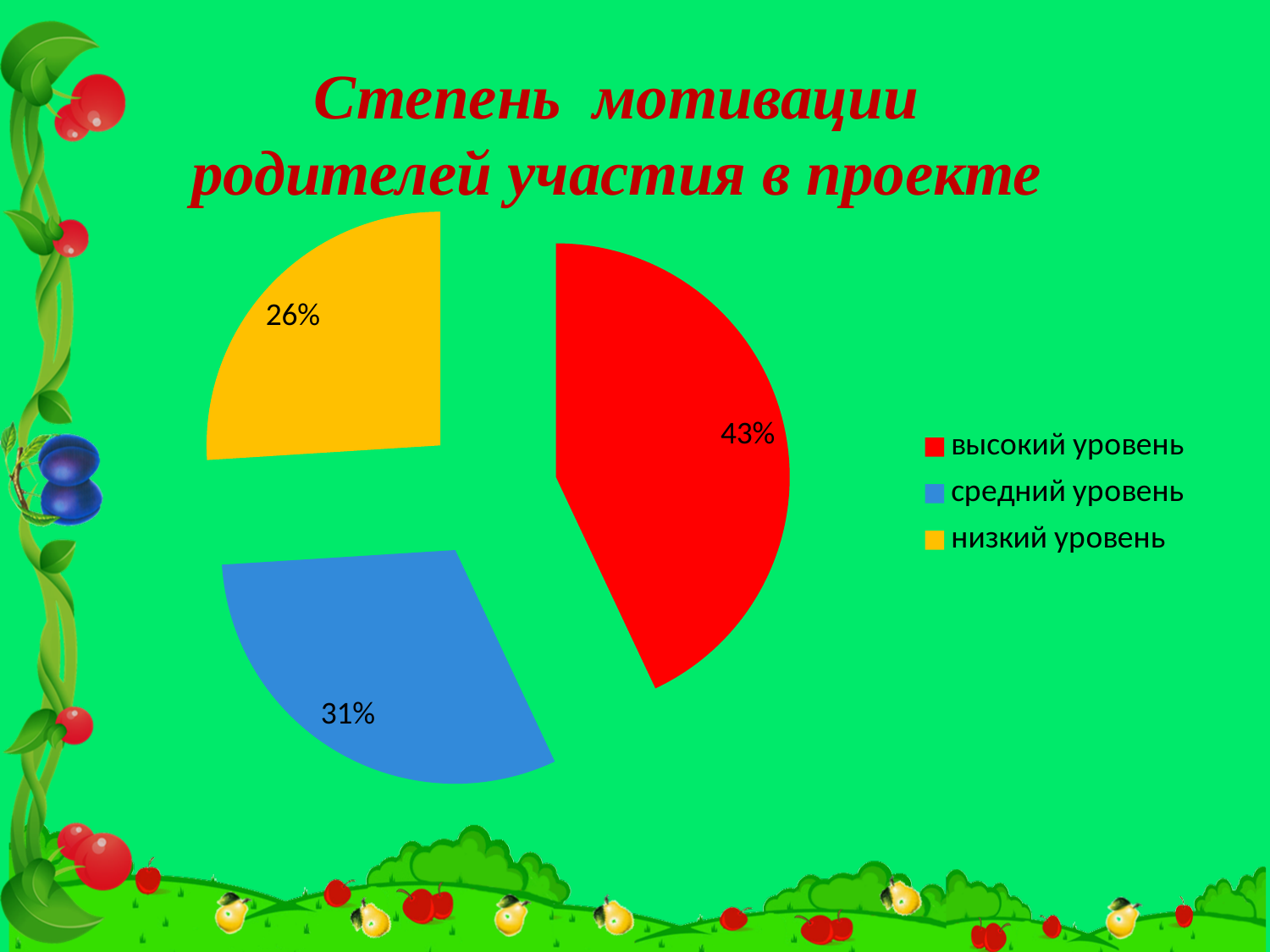
What percentage is shown for средний уровень? 31% Which category has the smallest share of the pie? низкий уровень What percentage is shown for низкий уровень? 26% What is the difference in percentage points between средний уровень and низкий уровень? 5 Which category has the largest share of the pie? высокий уровень How many slices does the pie chart have? 3 What kind of chart is shown on the slide? pie chart Which is larger, the share for средний уровень or the share for низкий уровень? средний уровень What is the title of the slide? Степень мотивации родителей участия в проекте What percentage is shown for высокий уровень? 43% What colour is the slice for средний уровень? blue What is the difference in percentage points between высокий уровень and низкий уровень? 17